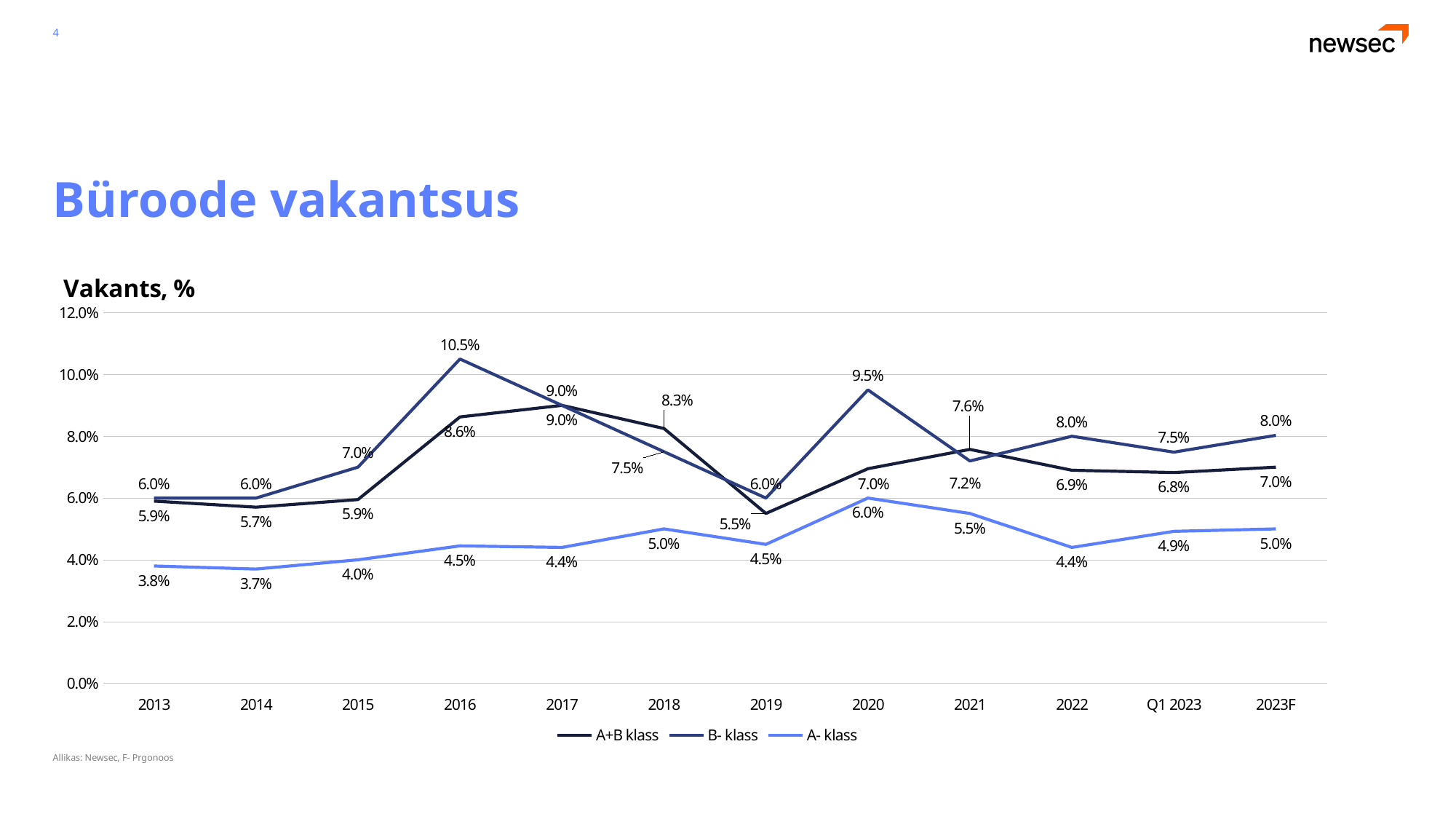
What type of chart is shown on the slide? line chart What is the difference between the B- klass and A- klass values in 2016? 6.0% In which year does the B- klass series reach its highest value? 2016 How many series does the legend list? 3 What is the A+B klass value for 2019? 5.5% What is the title of the chart's y-axis label shown above the plot? Vakants, % Which is larger in 2021: the A+B klass value or the B- klass value? A+B klass What is the B- klass vacancy value for 2016? 10.5% Does the A- klass series rise or fall from 2020 to 2022? fall What is the A- klass value for 2020? 6.0% In which year is the A- klass series at its lowest value? 2014 How many time points are shown on the x axis? 12